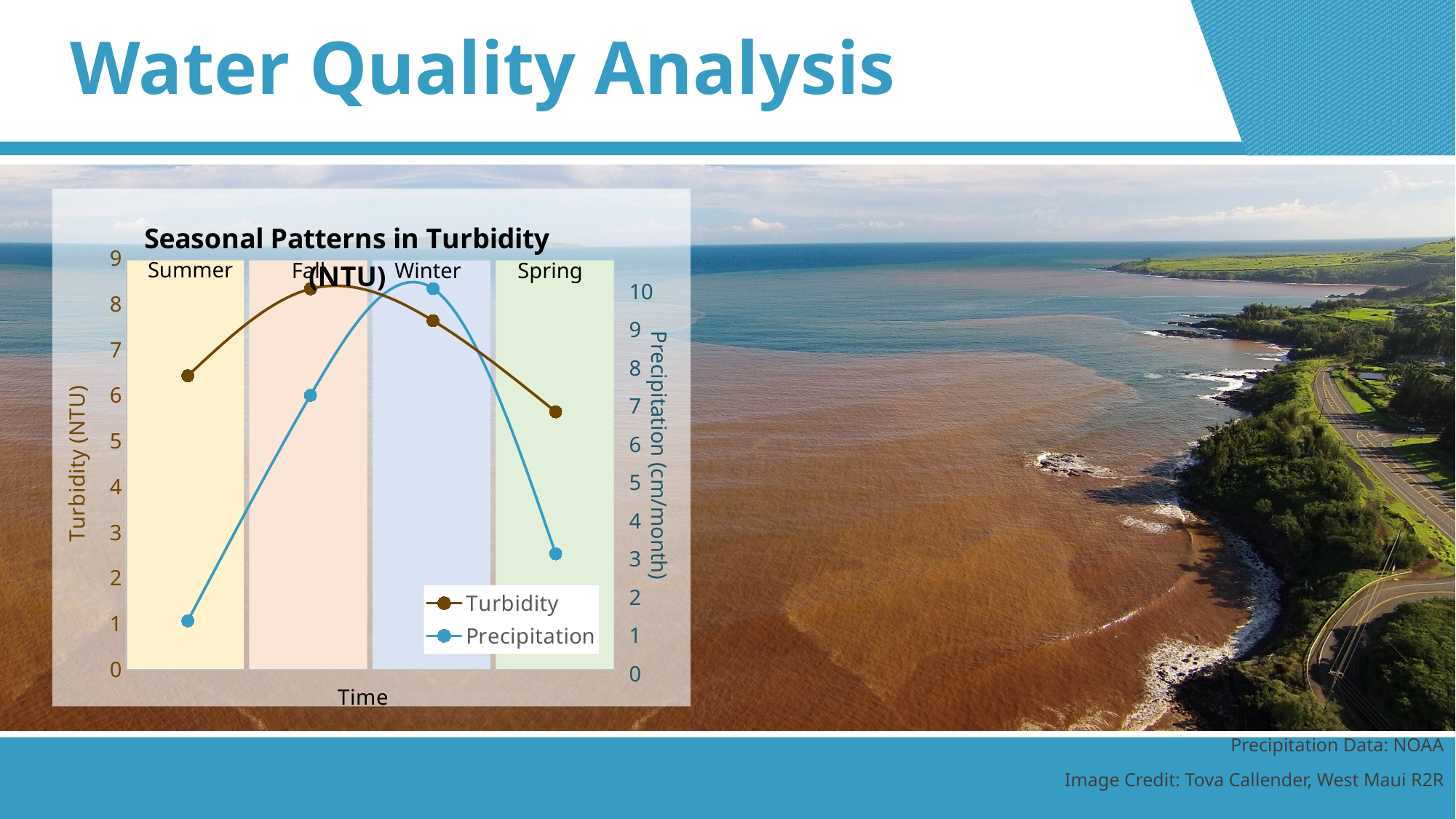
Is the Precipitation value for Summer greater or less than 2? less Is the Turbidity value for Fall greater or less than 8? greater Does Precipitation rise or fall from Summer to Winter? Rise In which season is Precipitation lowest? Summer In which season is Turbidity lowest? Spring In which season is Precipitation highest? Winter What kind of chart is shown on the slide? Line chart In which season is Turbidity highest? Fall How many series does the legend list? 2 How many seasons are plotted along the x axis? 4 Is the Precipitation value for Spring greater or less than 4? less Which season has the larger Precipitation value, Fall or Spring? Fall